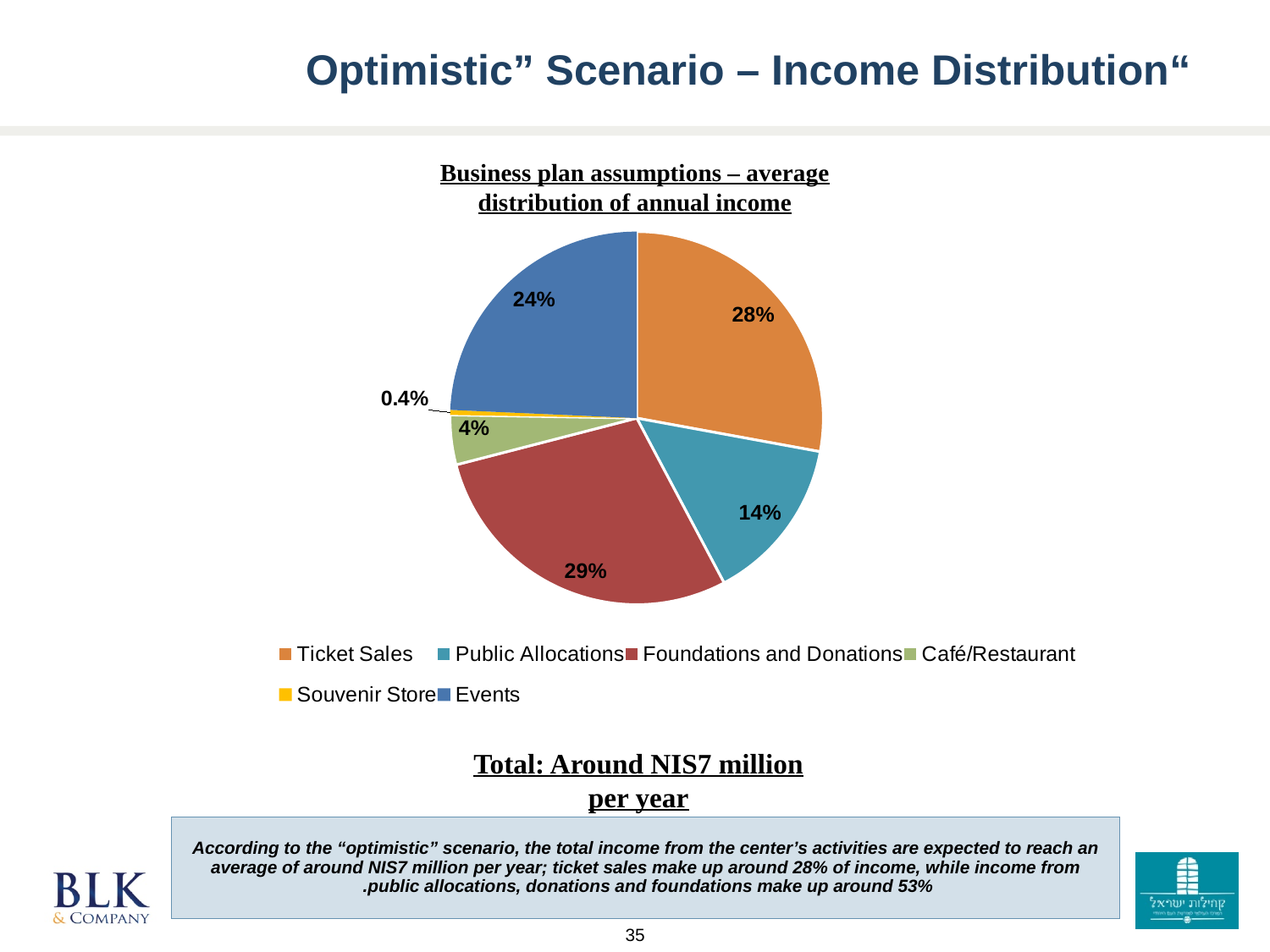
What is the difference in percentage points between the Events share and the Public Allocations share? 10 percentage points Which is larger, the share for Café/Restaurant or the share for Public Allocations? Public Allocations Which income source has the largest share of the pie? Foundations and Donations What share of annual income comes from Events? 24% What share of annual income comes from Public Allocations? 14% What is the title of the chart? Business plan assumptions – average distribution of annual income What share of annual income comes from Foundations and Donations? 29% Which income source has the smallest share of the pie? Souvenir Store How many income categories does the legend list? 6 What share of annual income comes from the Souvenir Store? 0.4% What share of annual income comes from Ticket Sales? 28% What kind of chart is shown on the slide? Pie chart